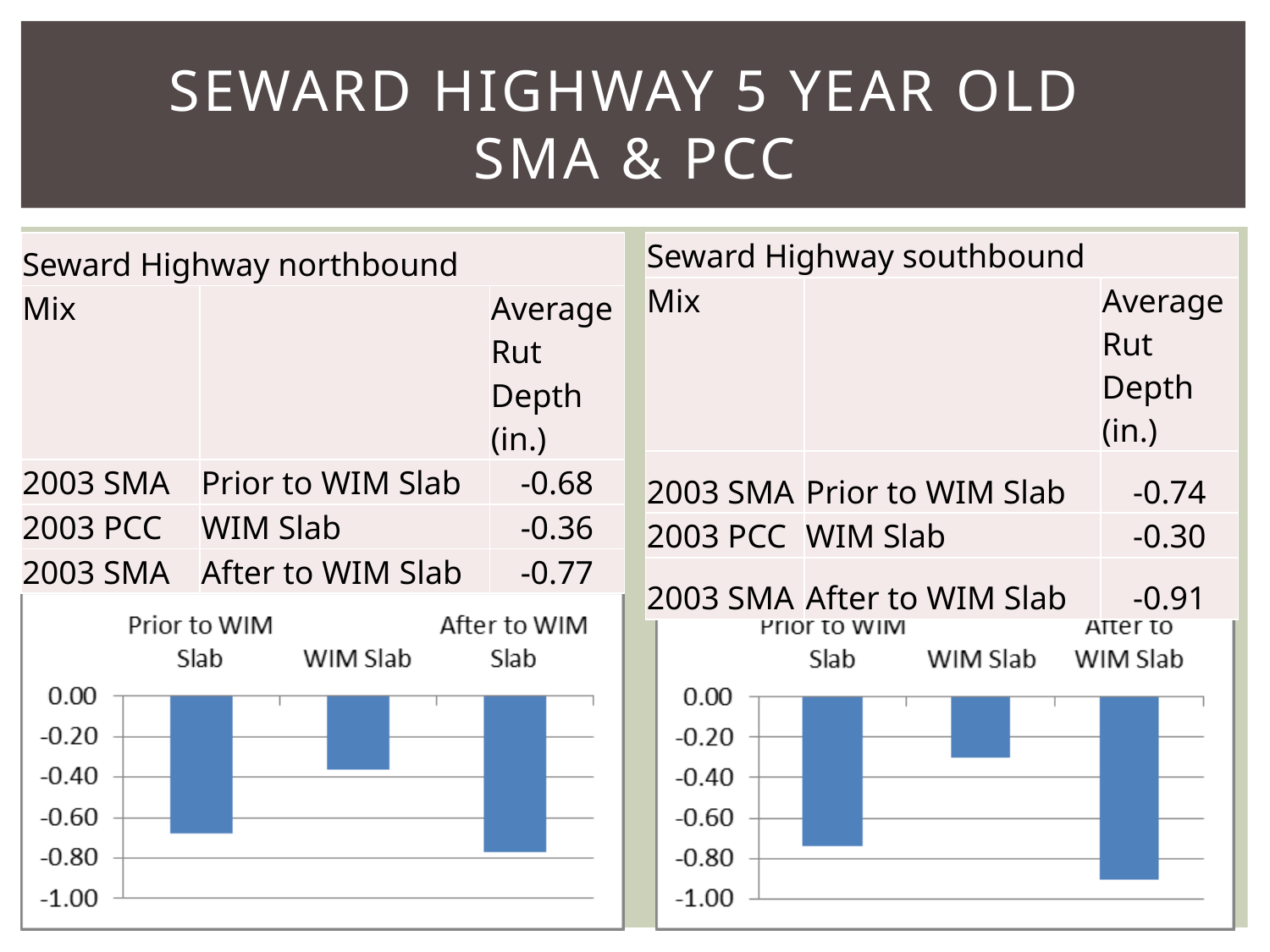
In the Seward Highway northbound chart, what is the value for WIM Slab? -0.36 In the Seward Highway southbound chart, what is the lowest tick value shown on the vertical axis? -1.00 What type of chart is used for the Seward Highway northbound data? Bar chart In the Seward Highway northbound chart, what is the average rut depth for Prior to WIM Slab? -0.68 In the Seward Highway northbound chart, is the value for After to WIM Slab greater or less than -0.60? less In the Seward Highway southbound chart, what is the difference between the Prior to WIM Slab value and the WIM Slab value? 0.44 In the Seward Highway northbound chart, which category has the highest (least negative) value? WIM Slab In the Seward Highway northbound chart, what is the difference between the After to WIM Slab value and the Prior to WIM Slab value? 0.09 In the Seward Highway southbound chart, which bar is more negative: Prior to WIM Slab or After to WIM Slab? After to WIM Slab How many categories are shown in the Seward Highway southbound chart? 3 In the Seward Highway southbound chart, which category has the lowest (most negative) value? After to WIM Slab In the Seward Highway southbound chart, what is the average rut depth for After to WIM Slab? -0.91